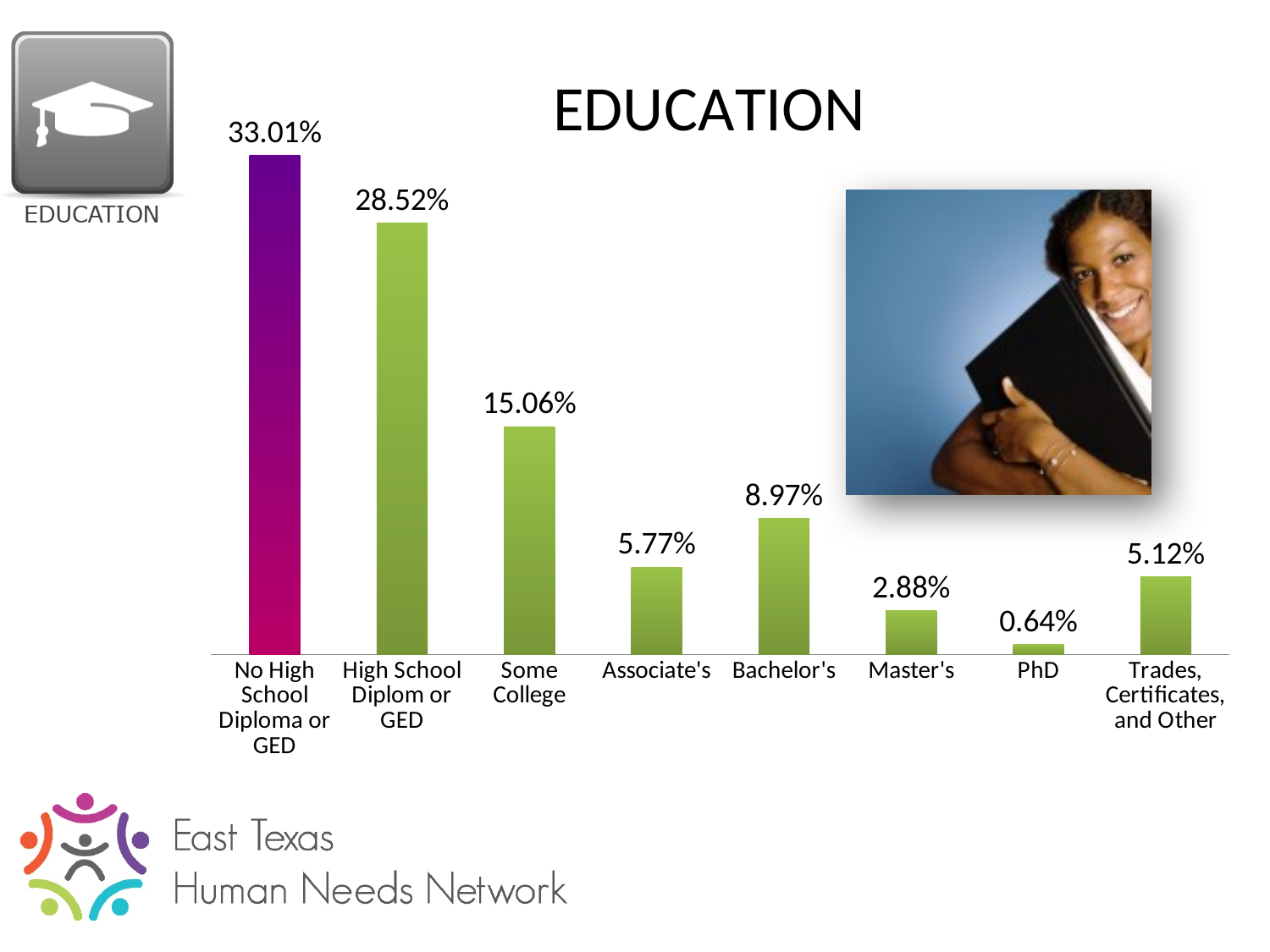
What kind of chart is shown on the slide? Bar chart Which category has the highest value? No High School Diploma or GED How many categories are shown in the chart? 8 What is the value for Bachelor's? 8.97% What is the title of the chart? EDUCATION What is the difference between the values for Bachelor's and Master's? 6.09% What is the value for Trades, Certificates, and Other? 5.12% Which bar is coloured differently from the others? No High School Diploma or GED What is the difference between the values for No High School Diploma or GED and High School Diplom or GED? 4.49% Which is larger, the value for Associate's or the value for Trades, Certificates, and Other? Associate's What is the value for Some College? 15.06% Which category has the lowest value? PhD